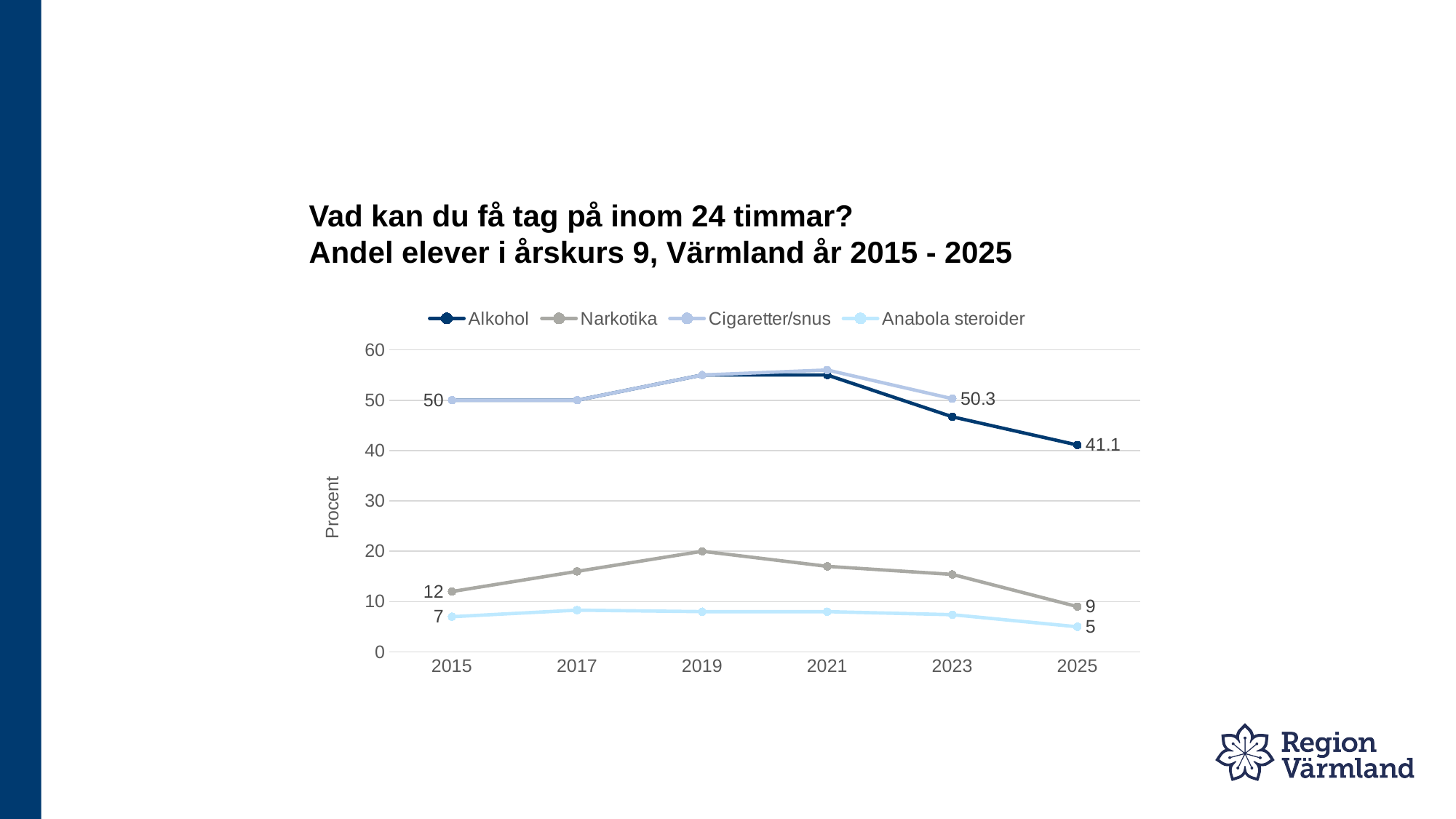
What is the value for Cigaretter/snus in 2023? 50.3 What is the value for Anabola steroider in 2025? 5 By how much did the value for Narkotika fall from 2015 to 2025? 3 What is the value for Narkotika in 2015? 12 How many years are shown on the x axis? 6 What kind of chart is shown on the slide? line chart Which series has the lowest value in 2025? Anabola steroider What is the label on the y axis? Procent How many series does the legend list? 4 What is the value for Alkohol in 2025? 41.1 Is the value for Narkotika in 2019 greater or less than 10? greater Does the value for Alkohol rise or fall from 2021 to 2025? fall